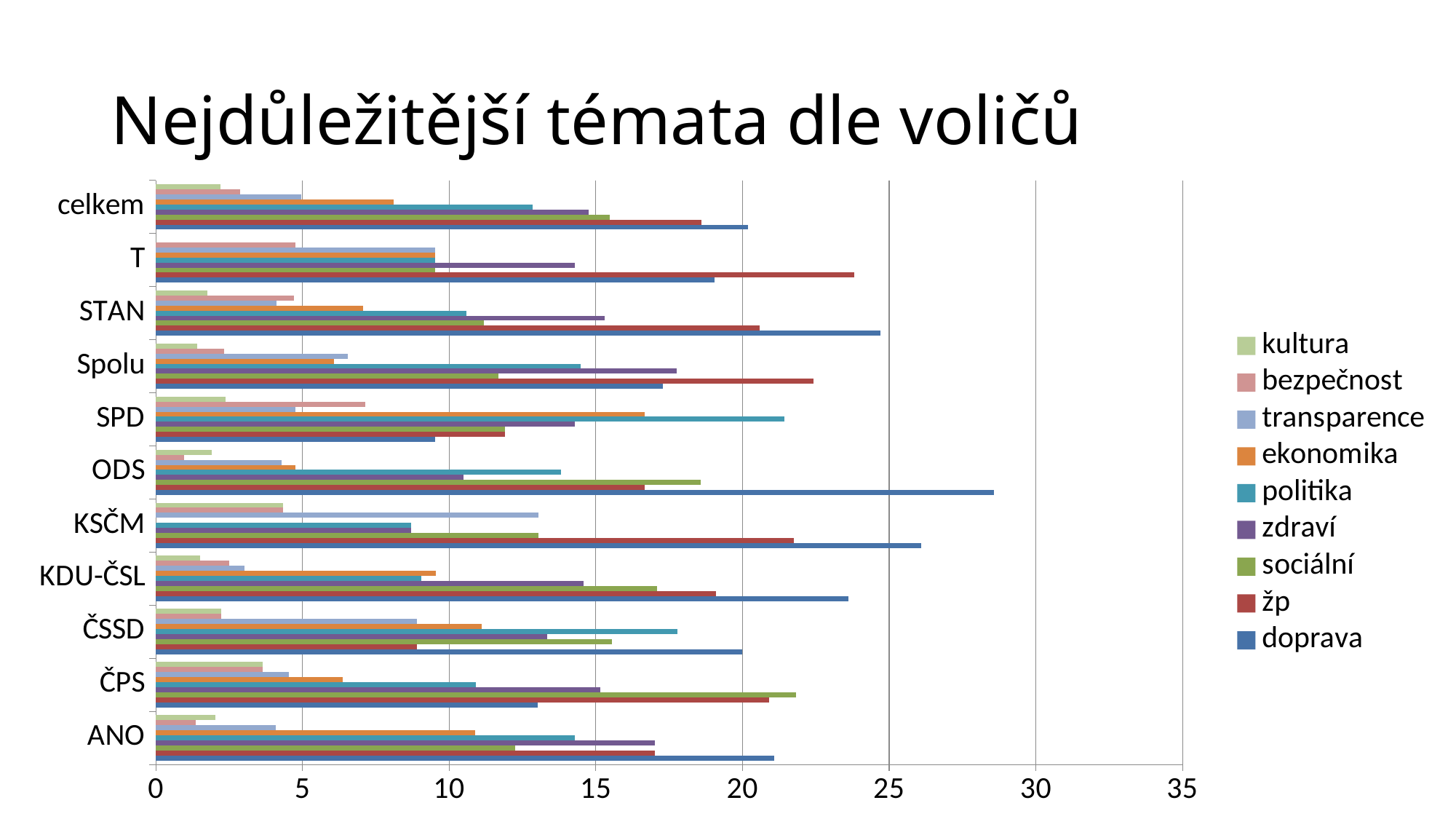
Which category has the longest doprava bar? ODS What kind of chart is shown on the slide? bar chart How many series does the chart legend list? 9 For SPD, which is larger: the politika value or the doprava value? politika How many categories (parties/groups) are listed on the vertical axis of the chart? 11 Which series is listed first in the chart legend? kultura Is the žp value for T greater or less than 20? greater For ČPS, which is larger: the sociální value or the doprava value? sociální What is the title of the chart on the slide? Nejdůležitější témata dle voličů Is the doprava value for ODS greater or less than 25? greater Is the doprava value for SPD greater or less than 10? less Which category has the shortest doprava bar? SPD